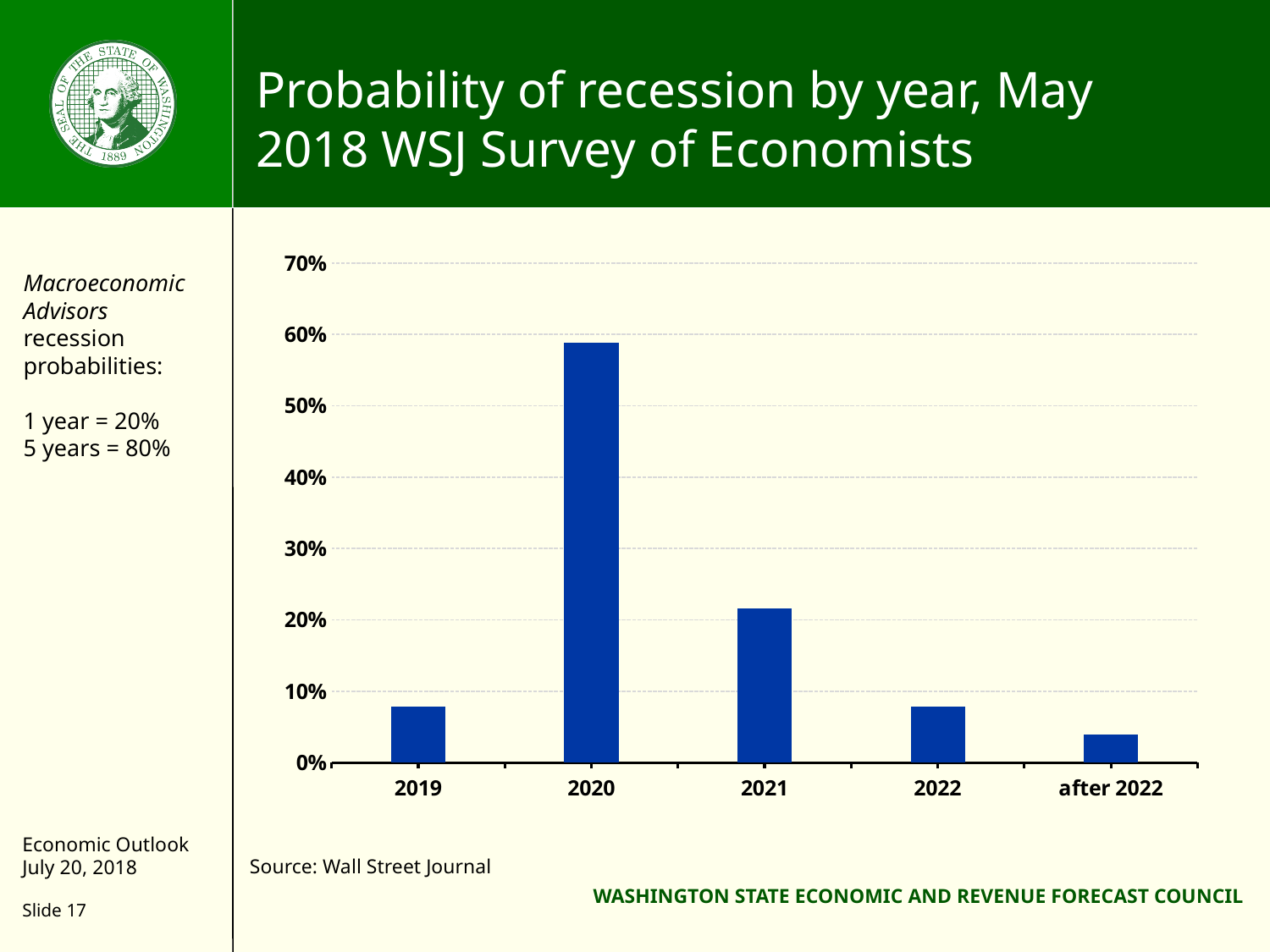
Is the value for 2021 greater or less than 30%? less Is the value for 2019 greater or less than 10%? less Is the value for after 2022 greater or less than 10%? less Which year has the highest probability of recession in the chart? 2020 Which has a higher probability of recession, 2021 or 2022? 2021 What kind of chart is shown on the slide? bar chart Which has a higher probability of recession, 2020 or 2021? 2020 Do the values rise or fall from 2020 through after 2022? fall Which category has the lowest probability of recession in the chart? after 2022 What is the source cited below the chart? Wall Street Journal How many categories are shown on the x axis of the chart? 5